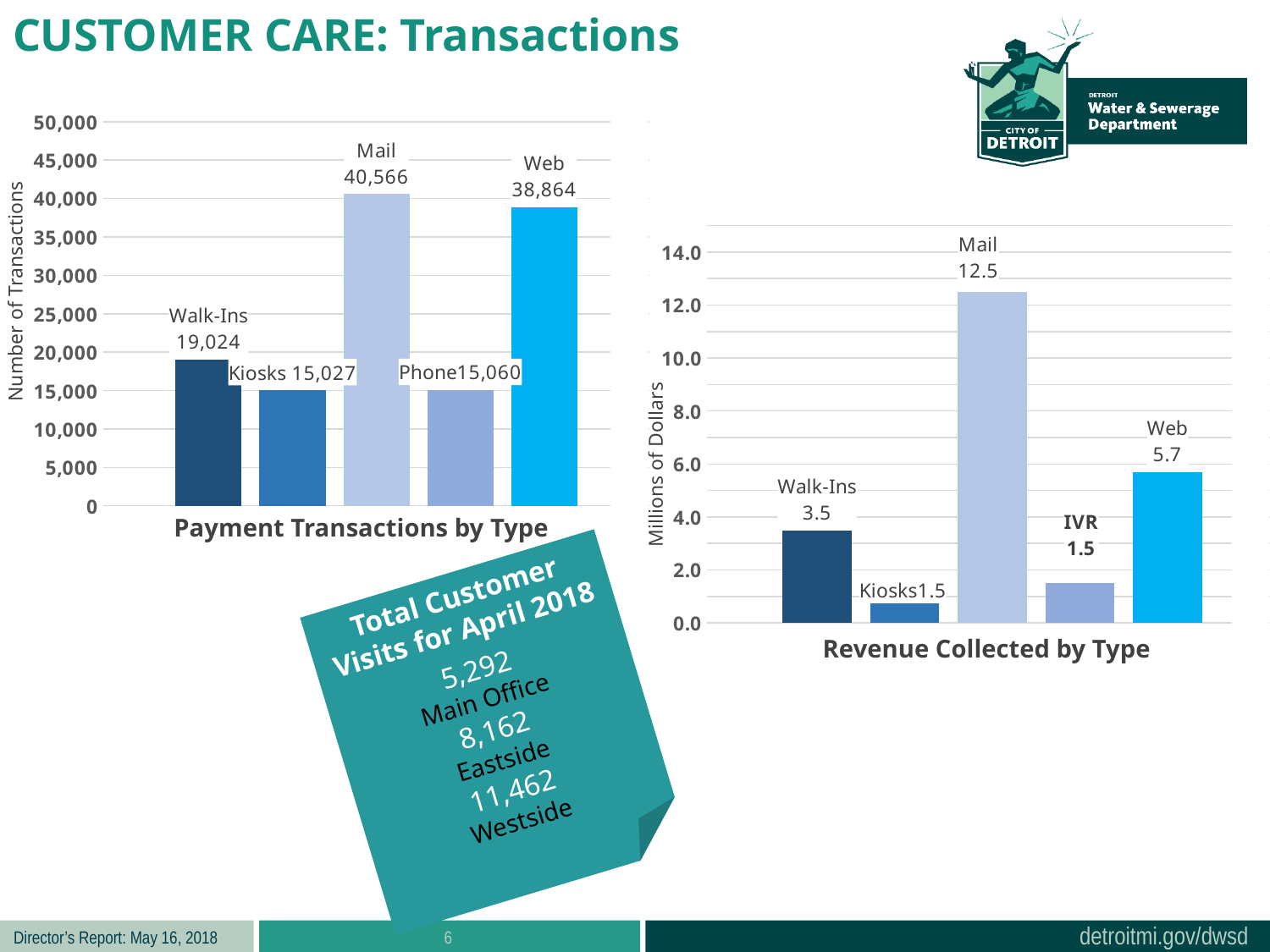
What is the y-axis label of the Revenue Collected by Type chart? Millions of Dollars In the Payment Transactions by Type chart, how many transactions were made by Mail? 40,566 In the Revenue Collected by Type chart, which type collected the most revenue? Mail In the Revenue Collected by Type chart, what is the difference between Mail and Walk-Ins revenue? 9.0 In the Payment Transactions by Type chart, which payment type has the highest number of transactions? Mail In the Revenue Collected by Type chart, how much revenue was collected by Web? 5.7 What type of chart is the Revenue Collected by Type chart? Bar chart In the Payment Transactions by Type chart, how many transactions were Walk-Ins? 19,024 In the Revenue Collected by Type chart, how much revenue was collected through IVR? 1.5 In the Payment Transactions by Type chart, which is larger, Walk-Ins or Kiosks? Walk-Ins In the Payment Transactions by Type chart, how many payment types are shown? 5 In the Payment Transactions by Type chart, what is the difference between the Mail and Web transaction counts? 1,702